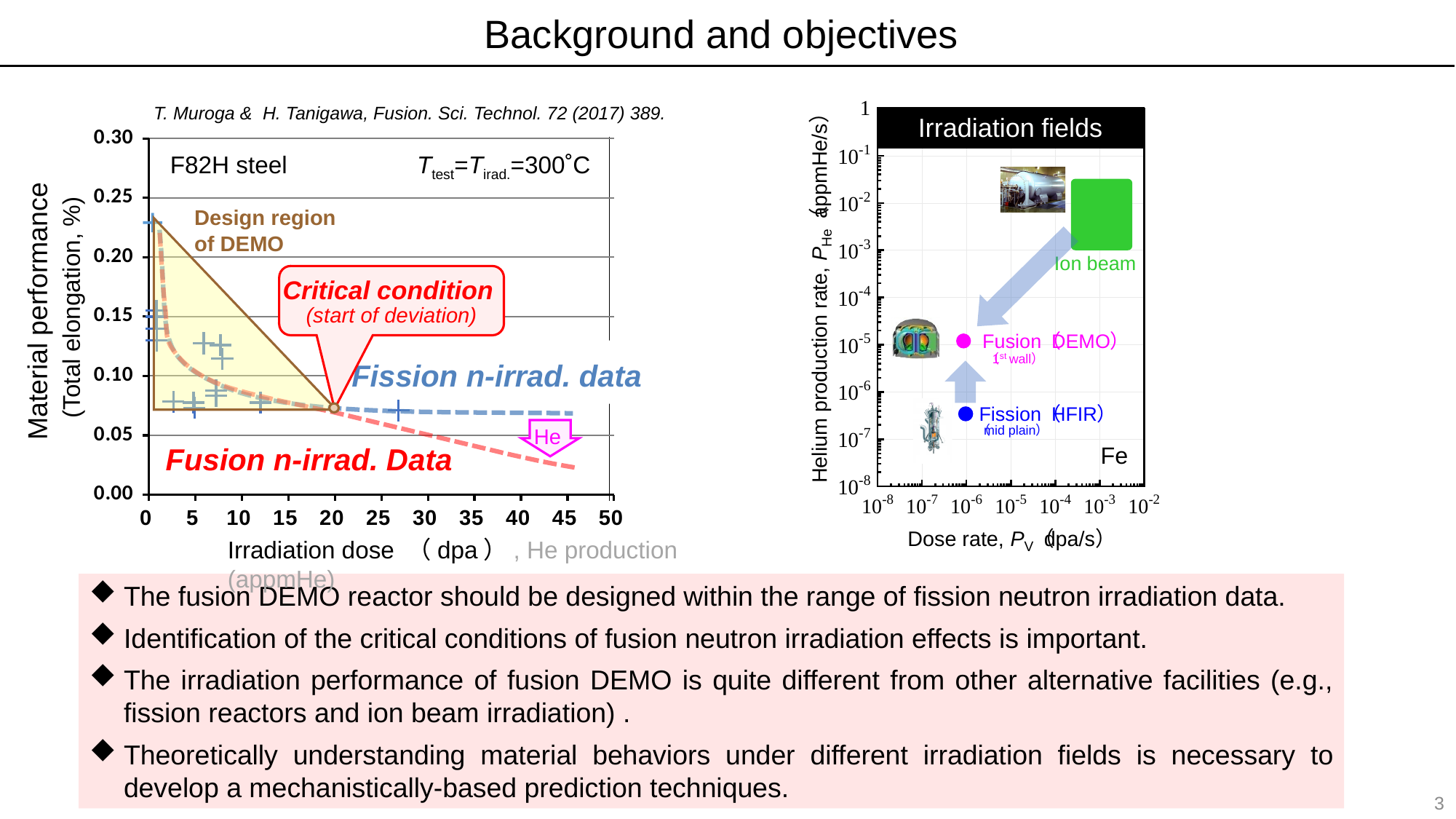
On the left chart (F82H steel), at what irradiation dose in dpa is the critical condition (start of deviation) marked? 20 On the left chart (F82H steel), what is the test and irradiation temperature stated? 300°C On the left chart (F82H steel), is the fusion n-irrad. data line at 45 dpa greater or less than 0.05? less On the left chart (F82H steel), does the fusion n-irrad. data line rise or fall as irradiation dose increases beyond 20 dpa? fall On the right chart (Irradiation fields), is the helium production rate for Fission (HFIR) greater or less than 10^-6 appmHe/s? less On the right chart (Irradiation fields), is the helium production rate for Fusion (DEMO) greater or less than 10^-6 appmHe/s? greater On the left chart (F82H steel), what is the x-axis label? Irradiation dose (dpa), He production (appmHe) On the right chart (Irradiation fields), which has the higher helium production rate, Fusion (DEMO) or Fission (HFIR)? Fusion (DEMO) On the right chart (Irradiation fields), how many labeled irradiation facilities are plotted? 3 On the left chart (F82H steel), which line is higher at 40 dpa, the fission n-irrad. data or the fusion n-irrad. data? Fission n-irrad. data